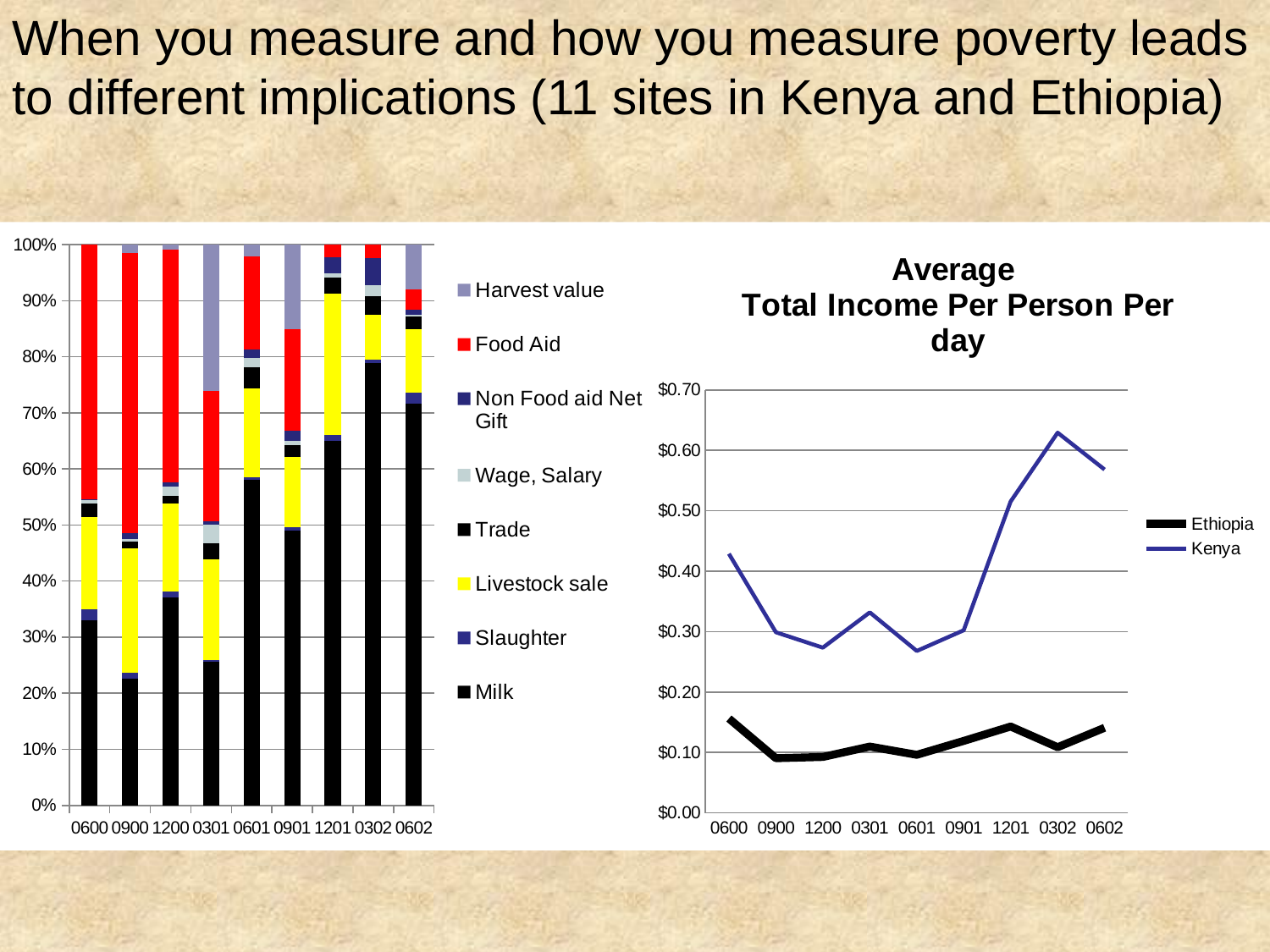
In the left stacked bar chart, which site has the largest Milk share? 0302 In the left stacked bar chart, is the Milk share for site 0601 greater or less than 50%? greater In the 'Average Total Income Per Person Per day' chart, is the Kenya value for site 0302 greater or less than $0.60? greater What kind of chart is the 'Average Total Income Per Person Per day' chart? Line chart What kind of chart is the chart on the left of the slide? Stacked bar chart In the 'Average Total Income Per Person Per day' chart, is the Ethiopia value for site 0600 greater or less than $0.20? less How many site categories are shown on the x axis of the 'Average Total Income Per Person Per day' chart? 9 In the 'Average Total Income Per Person Per day' chart, which series has the larger value at site 0302, Ethiopia or Kenya? Kenya How many series does the legend of the left stacked bar chart list? 8 In the 'Average Total Income Per Person Per day' chart, at which site is the Kenya value highest? 0302 How many series does the legend of the 'Average Total Income Per Person Per day' chart list? 2